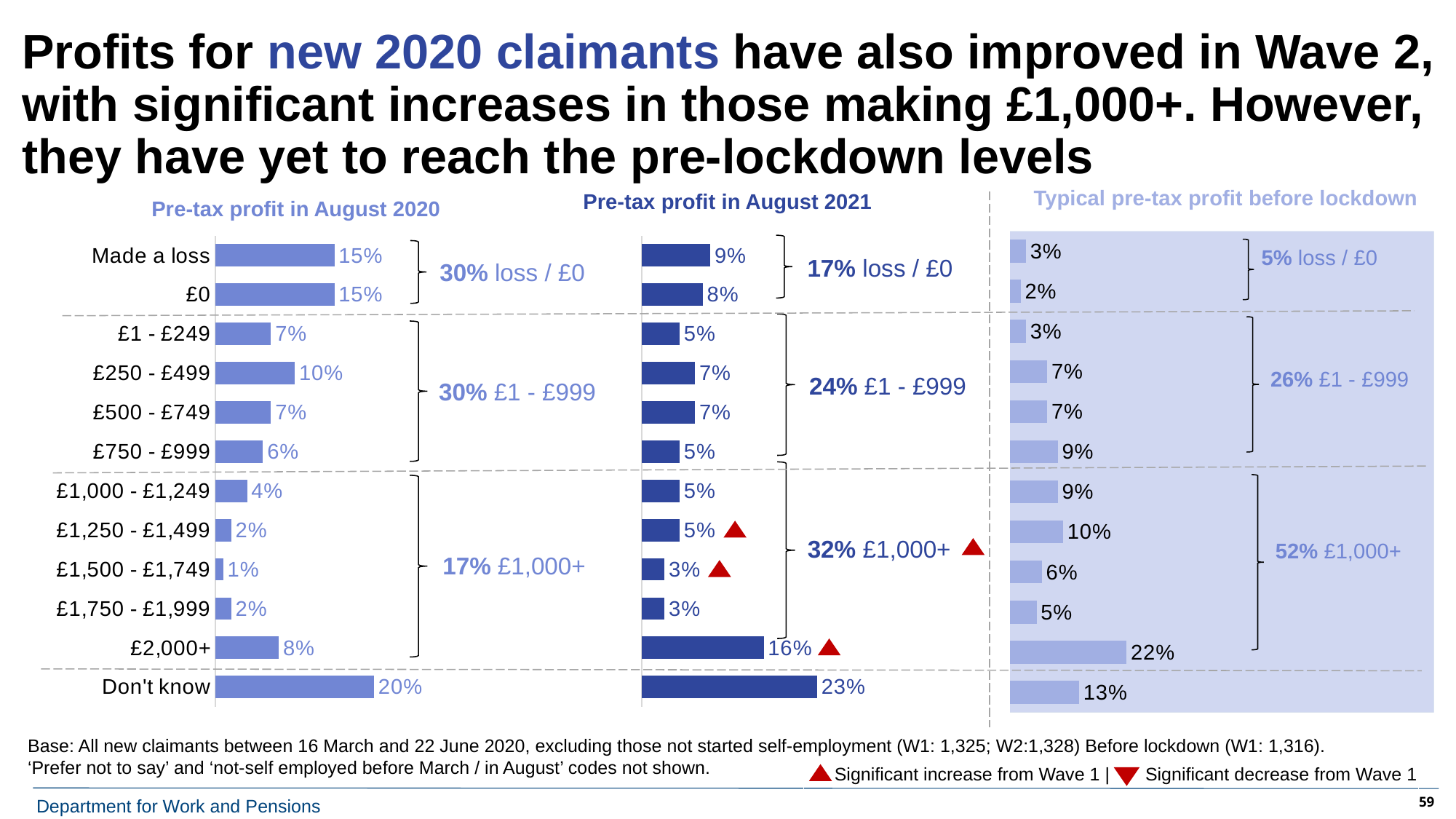
In the 'Pre-tax profit in August 2021' chart, what combined share is shown by the bracket for £1,000+? 32% How many categories are shown in the 'Pre-tax profit in August 2020' chart? 12 In the 'Typical pre-tax profit before lockdown' chart, what is the value for Don't know? 13% In the 'Typical pre-tax profit before lockdown' chart, what is the value for £2,000+? 22% How much higher is the £2,000+ value in the 'Typical pre-tax profit before lockdown' chart than in the 'Pre-tax profit in August 2021' chart? 6 percentage points In the 'Pre-tax profit in August 2021' chart, what is the value for £2,000+? 16% In the 'Pre-tax profit in August 2021' chart, which category has the highest value? Don't know What type of chart is the 'Pre-tax profit in August 2021' chart? Bar chart Is the value for Made a loss larger in the 'Pre-tax profit in August 2020' chart or the 'Pre-tax profit in August 2021' chart? Pre-tax profit in August 2020 What is the difference between the Don't know values in the 'Pre-tax profit in August 2021' chart and the 'Pre-tax profit in August 2020' chart? 3 percentage points In the 'Pre-tax profit in August 2020' chart, what is the value for £250 - £499? 10% In the 'Pre-tax profit in August 2020' chart, which category has the lowest value? £1,500 - £1,749